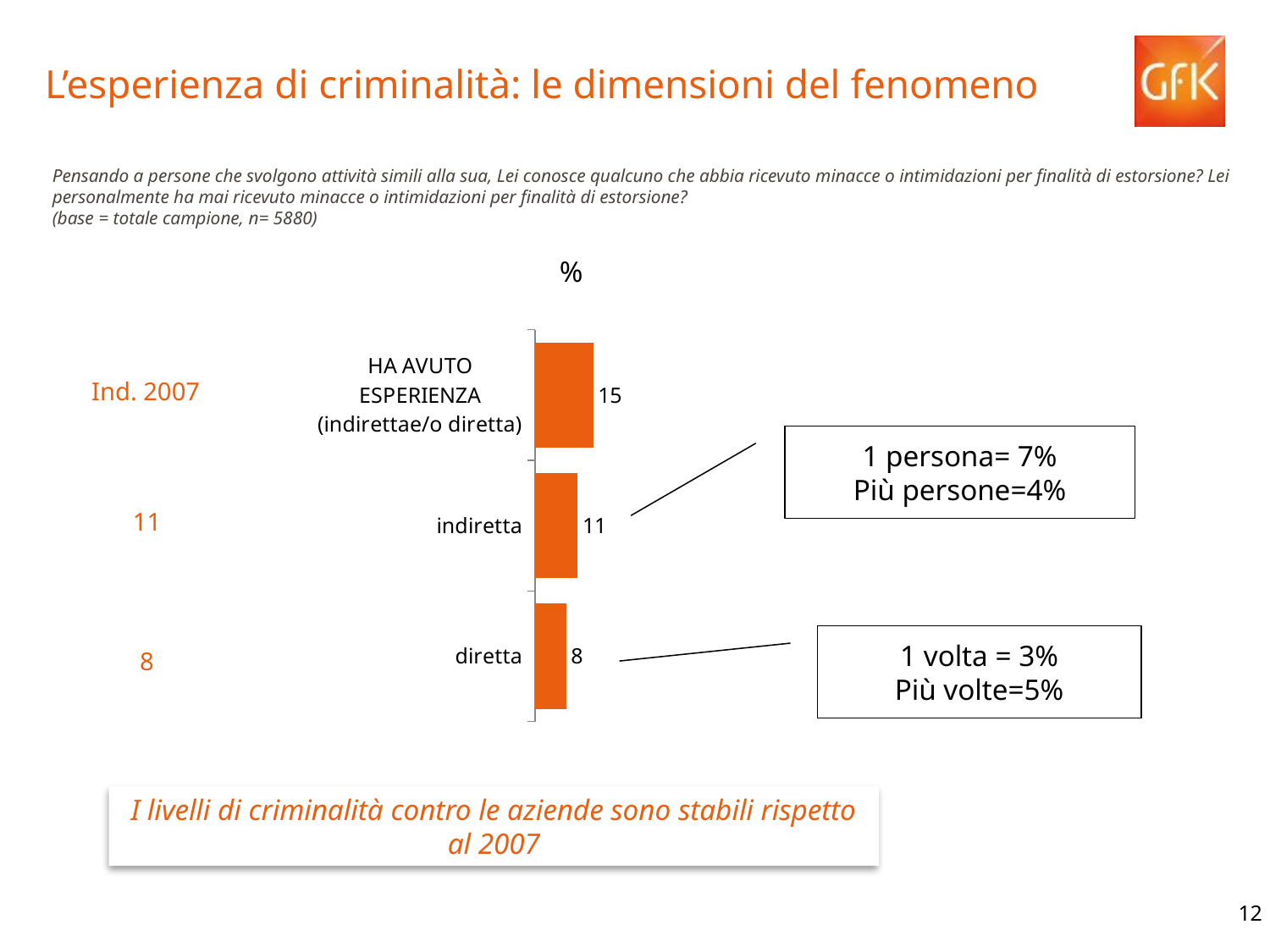
How many categories are shown in the bar chart? 3 Which is larger, the value for "indiretta" or the value for "diretta"? indiretta Which category has the highest value in the bar chart? HA AVUTO ESPERIENZA (indirettae/o diretta) Which category has the lowest value in the bar chart? diretta What is the difference between the values for "indiretta" and "diretta"? 3 What is the value for "indiretta" in the bar chart? 11 What is the value for "diretta" in the bar chart? 8 What kind of chart is shown on the slide? bar chart According to the "Ind. 2007" column on the left, what was the 2007 value for "diretta"? 8 What unit label is shown above the bar chart? % What is the difference between the values for "HA AVUTO ESPERIENZA" and "indiretta"? 4 What is the value for "HA AVUTO ESPERIENZA (indirettae/o diretta)" in the bar chart? 15